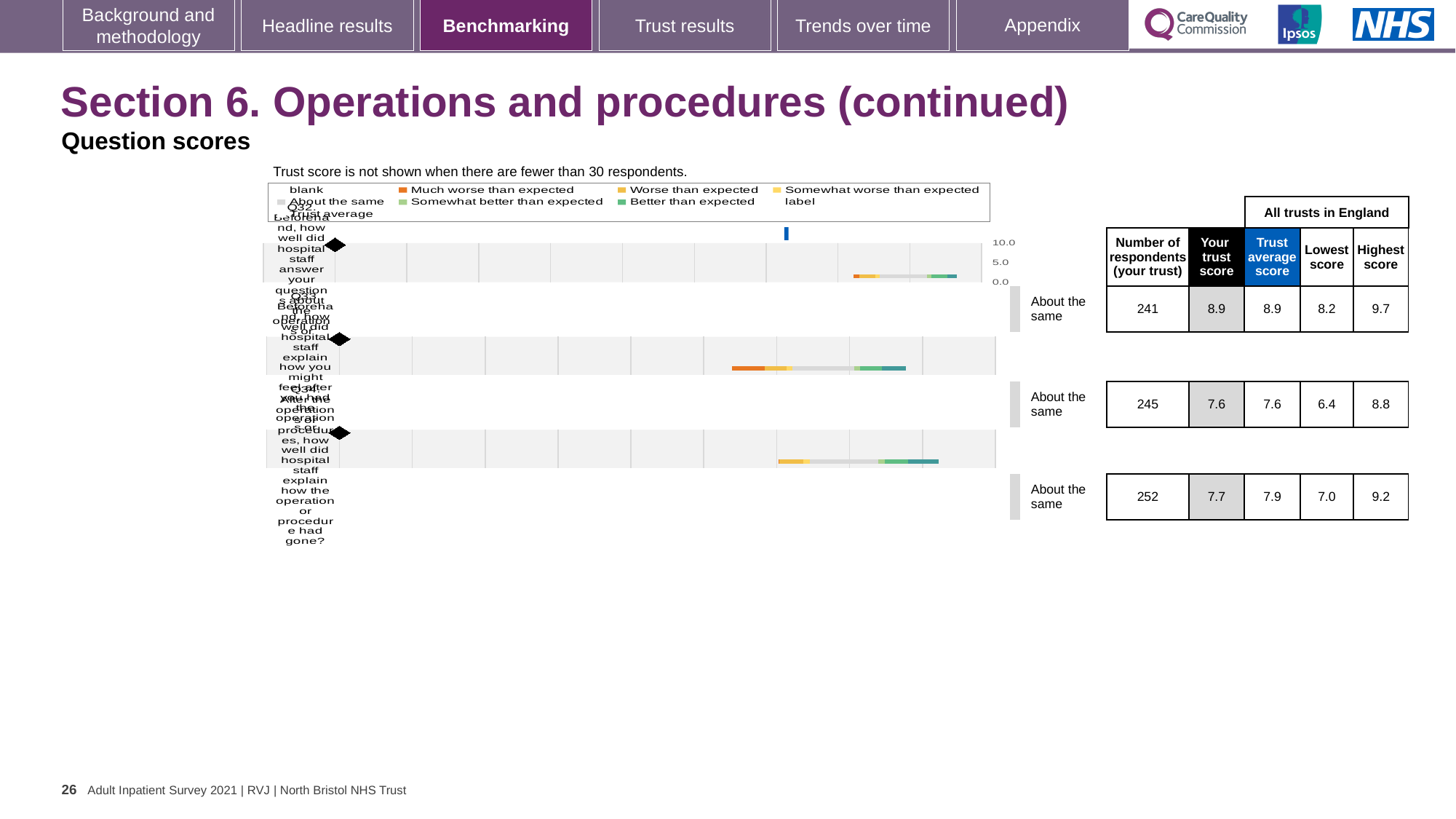
What is the trust score for Q34 in the table next to the chart? 7.7 Is the trust score for Q34 larger or smaller than the trust average score for Q34? smaller What is the trust score for Q32 in the table next to the chart? 8.9 What benchmark category is shown next to the chart for Q32? About the same Which question has the highest trust score in the table: Q32, Q33 or Q34? Q32 What is the trust score for Q33 in the table next to the chart? 7.6 Which legend entry is shown in orange in the chart legend? Much worse than expected What is the difference between the highest score and the lowest score for Q33 in the table? 2.4 Which question has the lowest trust score in the table: Q32, Q33 or Q34? Q33 What is the highest value shown on the horizontal axis of the first chart? 10.0 How many question charts are shown on the slide? 3 What kind of chart is used to show the benchmarking results for the questions on this slide? bar chart